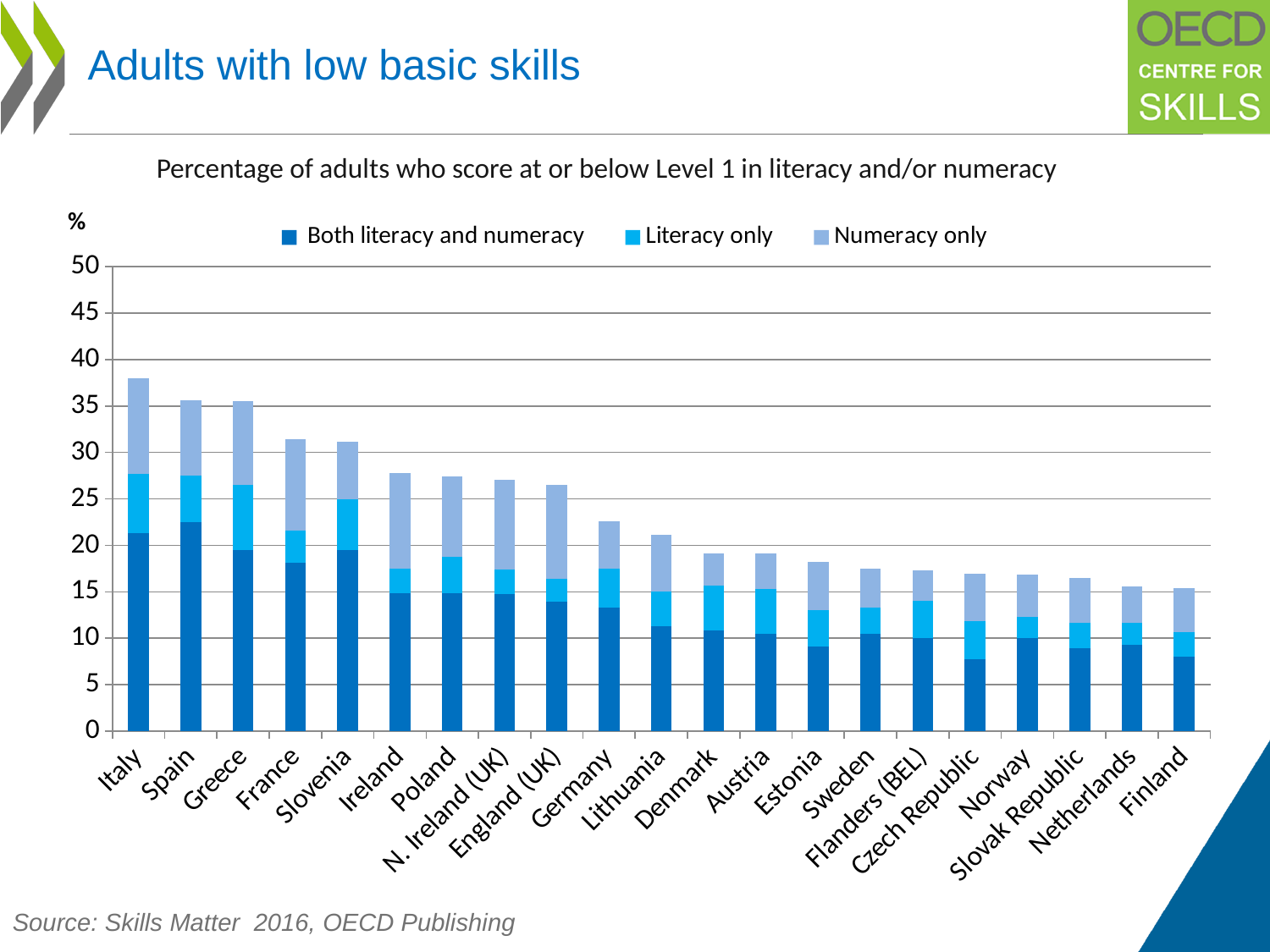
Which country has the highest total percentage of adults with low basic skills? Italy What kind of chart is shown on the slide? Stacked bar chart Is the total value for Finland greater or less than 20? less Which has the larger total bar, Greece or Germany? Greece Do the total bar heights rise or fall moving from left to right along the x axis? Fall How many series does the legend list? 3 Is the total value for Germany greater or less than 20? greater How many countries/regions are shown on the x axis? 21 Is the total value for Italy greater or less than 35? greater Which series is shown in the darkest blue at the bottom of each bar? Both literacy and numeracy What is the title of the chart? Percentage of adults who score at or below Level 1 in literacy and/or numeracy